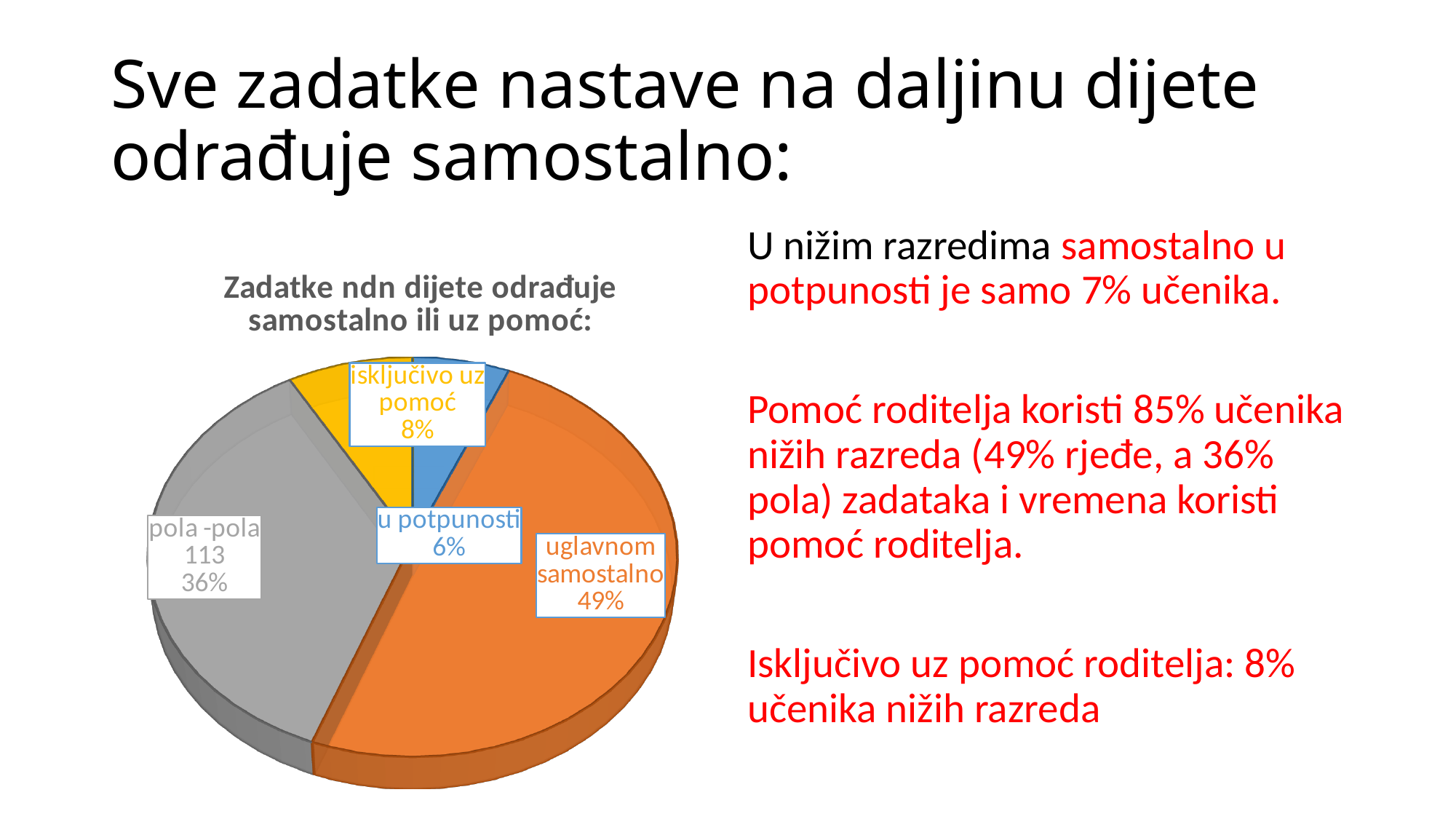
What kind of chart is shown on the slide? pie chart What percentage share does the 'uglavnom samostalno' slice have? 49% What count value is printed on the 'pola -pola' slice? 113 How many slices does the pie chart have? 4 What percentage share does the 'isključivo uz pomoć' slice have? 8% What is the title of the chart? Zadatke ndn dijete odrađuje samostalno ili uz pomoć: Which slice is the largest in the pie chart? uglavnom samostalno What percentage share does the 'u potpunosti' slice have? 6% Which slice is the smallest in the pie chart? u potpunosti Which slice is larger, 'isključivo uz pomoć' or 'u potpunosti'? isključivo uz pomoć What is the difference in percentage points between the 'uglavnom samostalno' and 'pola -pola' slices? 13